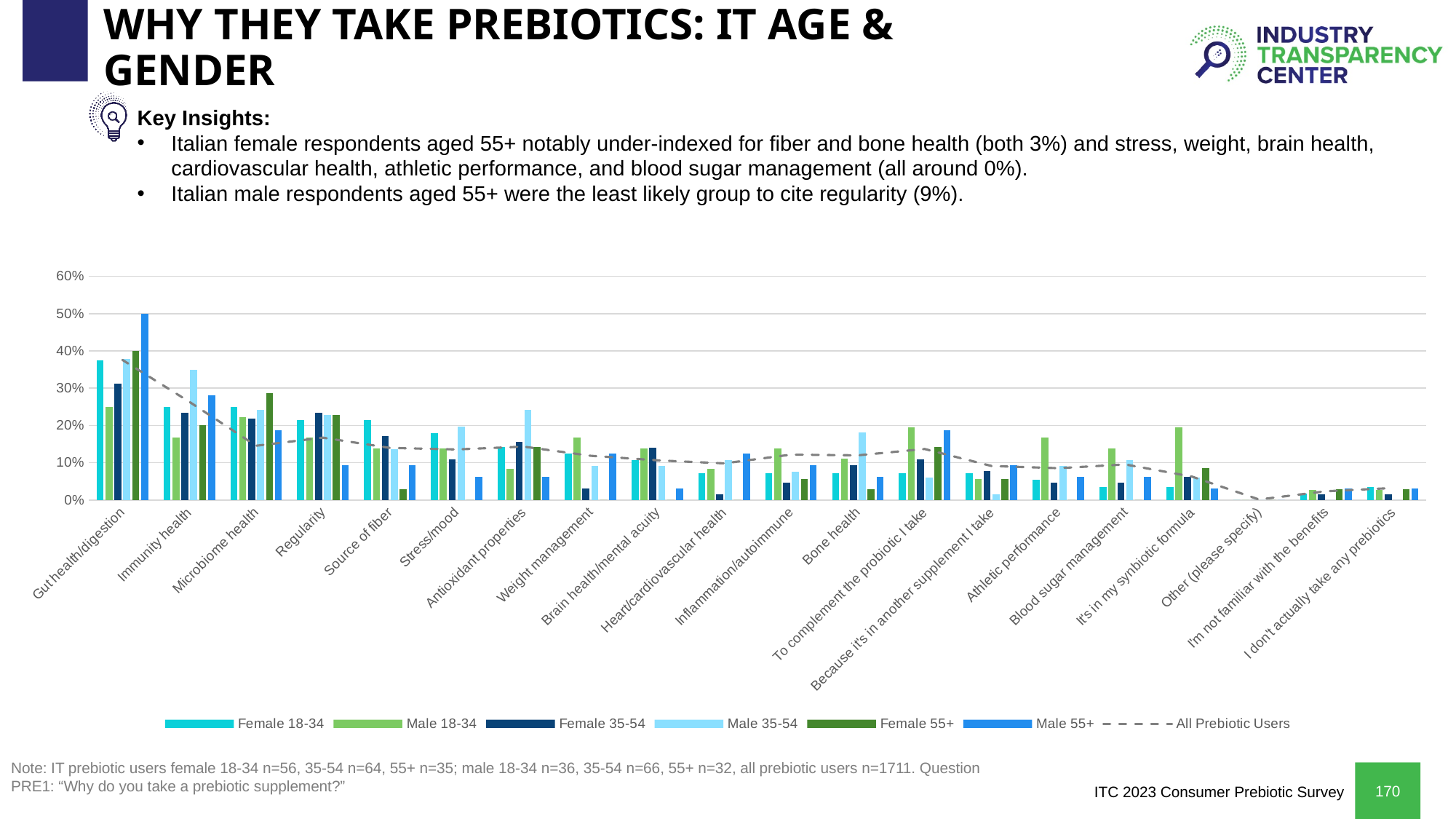
How many entries does the chart legend list? 8 Is the value for Male 55+ on Regularity greater or less than 10%? less What does the dashed grey line in the chart represent? All Prebiotic Users Which group has the highest value for Gut health/digestion? Male 55+ Is the value for Female 18-34 on Gut health/digestion greater or less than 30%? greater For Immunity health, which is larger: Male 35-54 or Female 35-54? Male 35-54 Is the value for Female 55+ on Microbiome health greater or less than 20%? greater What kind of chart is shown on the slide? combination bar and line chart How many reason categories are shown along the x axis of the chart? 20 For Gut health/digestion, which is larger: Female 18-34 or Male 18-34? Female 18-34